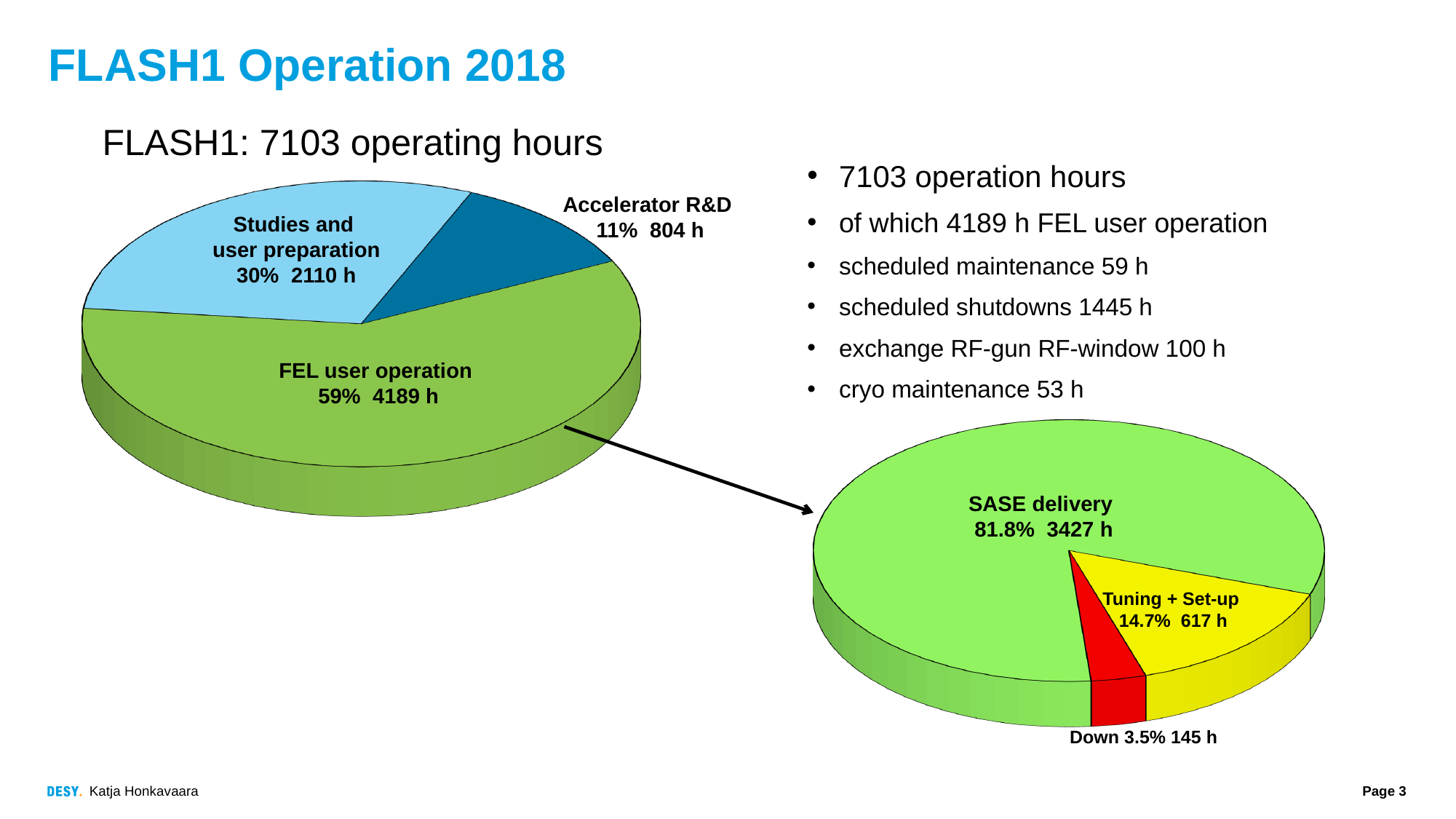
In the right pie chart, which slice is the smallest? Down In the right pie chart, which is larger: Tuning + Set-up or Down? Tuning + Set-up In the left pie chart, what percentage share is labelled for Studies and user preparation? 30% What type of chart is used on this slide? Pie chart In the left pie chart, how many slices are there? 3 In the left pie chart, which slice is the largest? FEL user operation In the left pie chart, which slice is the smallest? Accelerator R&D In the left pie chart, what is the difference in hours between Studies and user preparation and Accelerator R&D? 1306 h In the right pie chart, how many hours are shown for Tuning + Set-up? 617 h In the left pie chart (FLASH1: 7103 operating hours), how many hours are shown for FEL user operation? 4189 h In the right pie chart (FEL user operation breakdown), what percentage share is labelled for SASE delivery? 81.8% In the left pie chart, how many hours are shown for Accelerator R&D? 804 h